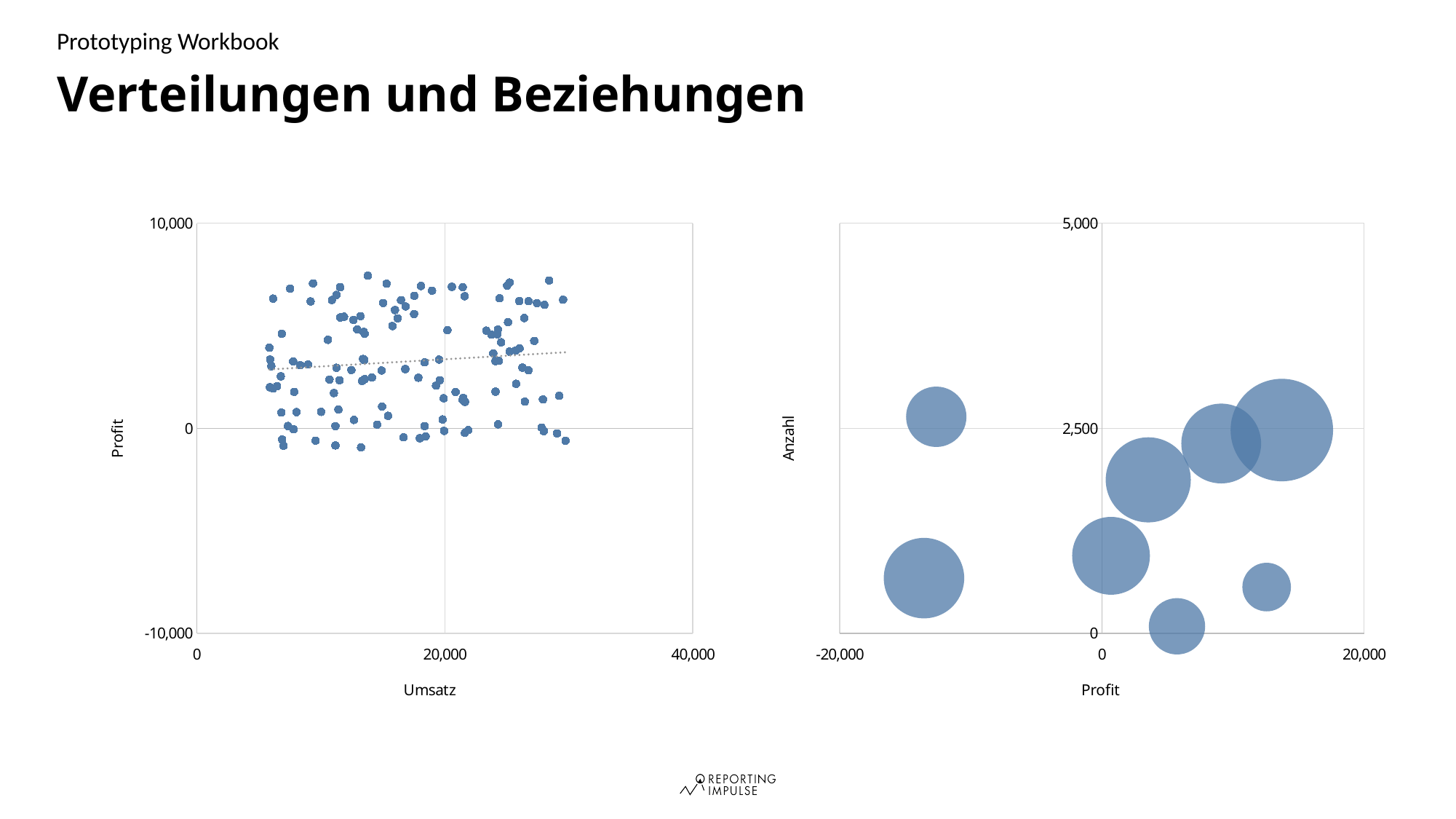
In the left chart, is the highest Profit value of any point greater or less than 10,000? less In the left chart, what is the label of the x axis? Umsatz In the left chart, is the largest Umsatz value of any point greater or less than 40,000? less In the right chart, is the Profit value of the rightmost bubble greater or less than 0? greater In the left chart, does the dotted trend line rise or fall as Umsatz increases? rises How many bubbles are plotted in the right chart? 8 What kind of chart is the right chart on the slide? bubble chart In the right chart, what is the label of the y axis? Anzahl In the right chart, how many bubbles have a Profit value less than 0? 2 What kind of chart is the left chart on the slide? scatter plot